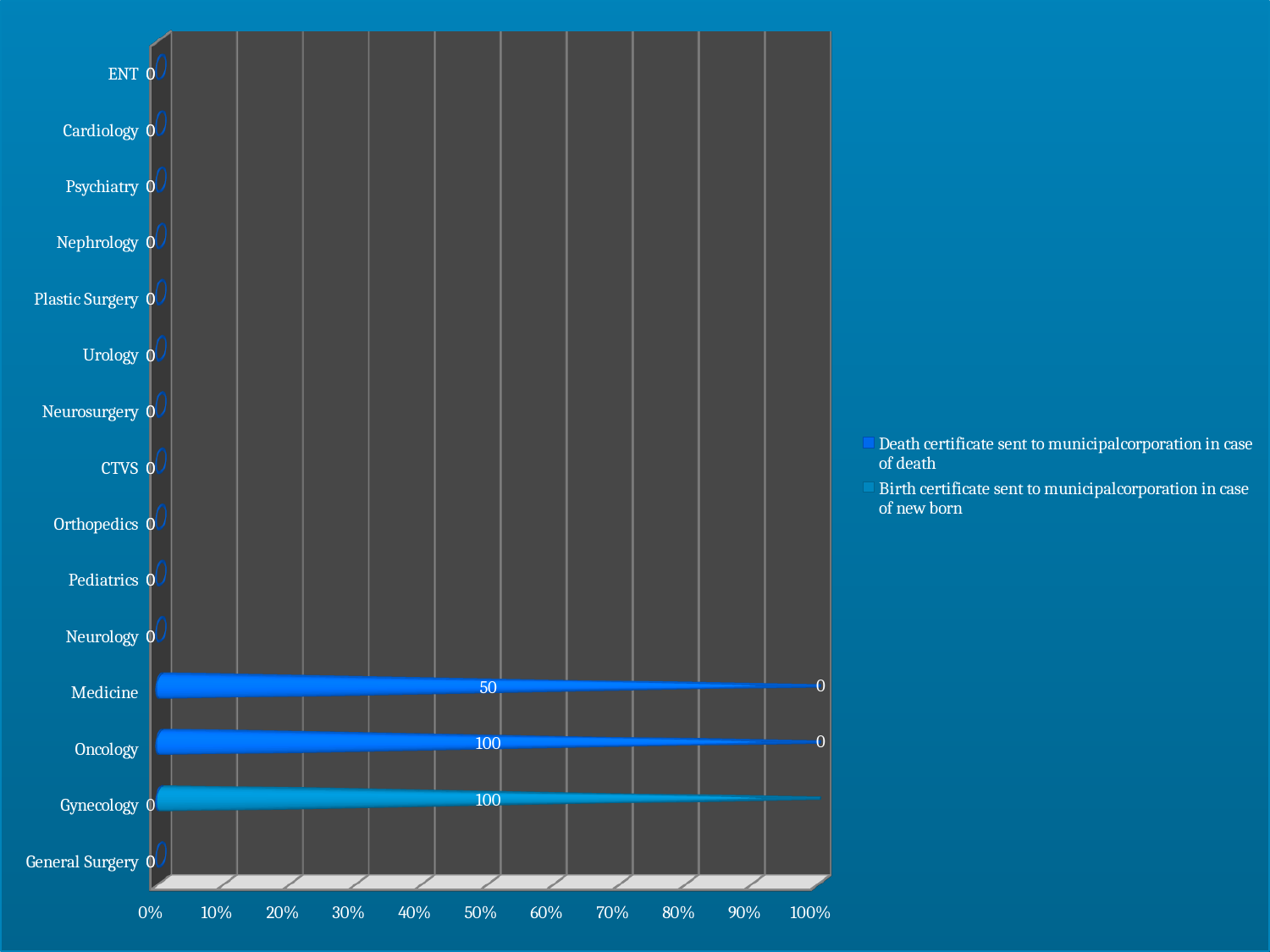
What is the value for Oncology in the 'Death certificate sent to municipal corporation in case of death' series? 100 Which department has the highest value for death certificates sent to the municipal corporation? Oncology What is the value for Gynecology in the 'Birth certificate sent to municipal corporation in case of new born' series? 100 Which department has the highest value for birth certificates sent to the municipal corporation? Gynecology Which has the larger death certificate value, Medicine or Oncology? Oncology How many series does the legend list? 2 What kind of chart is shown on the slide? bar chart What is the difference between the death certificate values for Oncology and Medicine? 50 Is the death certificate value for Medicine greater or less than 40%? greater How many departments (categories) are listed on the chart? 15 What is the value for Medicine in the 'Death certificate sent to municipal corporation in case of death' series? 50 What is the value for Gynecology in the 'Death certificate sent to municipal corporation in case of death' series? 0